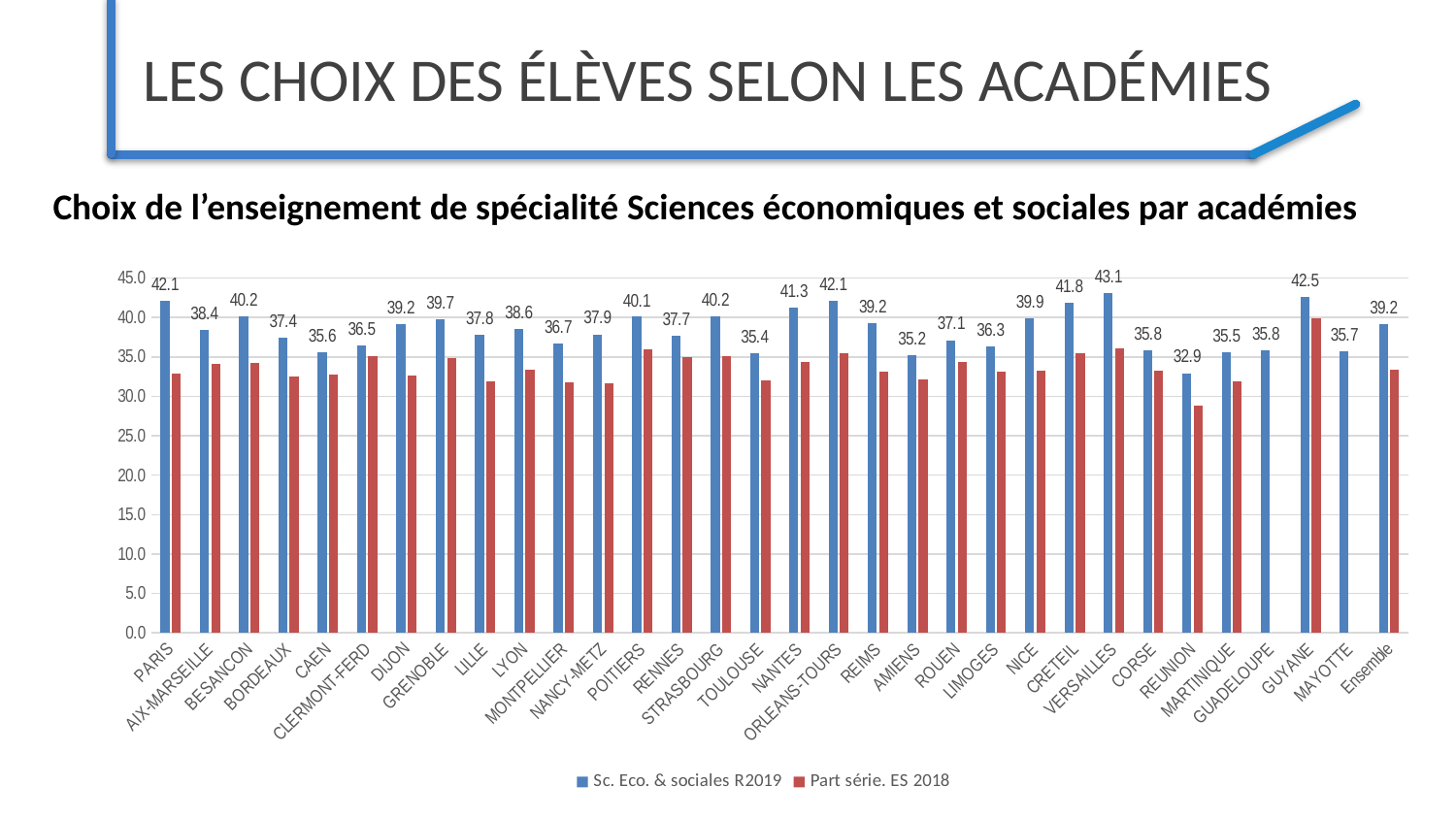
Which academy has the lowest value in the Sc. Eco. & sociales R2019 series? REUNION How many categories are shown on the x axis of the chart? 32 What is the difference between the Sc. Eco. & sociales R2019 values for GUYANE and MAYOTTE? 6.8 What is the value for VERSAILLES in the Sc. Eco. & sociales R2019 series? 43.1 In the Sc. Eco. & sociales R2019 series, which is larger: NANTES or REIMS? NANTES What is the value for REUNION in the Sc. Eco. & sociales R2019 series? 32.9 How many series does the legend list? 2 What is the value for Ensemble in the Sc. Eco. & sociales R2019 series? 39.2 What kind of chart is shown on the slide? Bar chart Is the Part série. ES 2018 value for REUNION greater or less than 30.0? less Is the Part série. ES 2018 value for GUYANE greater or less than 35.0? greater Which academy has the highest value in the Sc. Eco. & sociales R2019 series? VERSAILLES